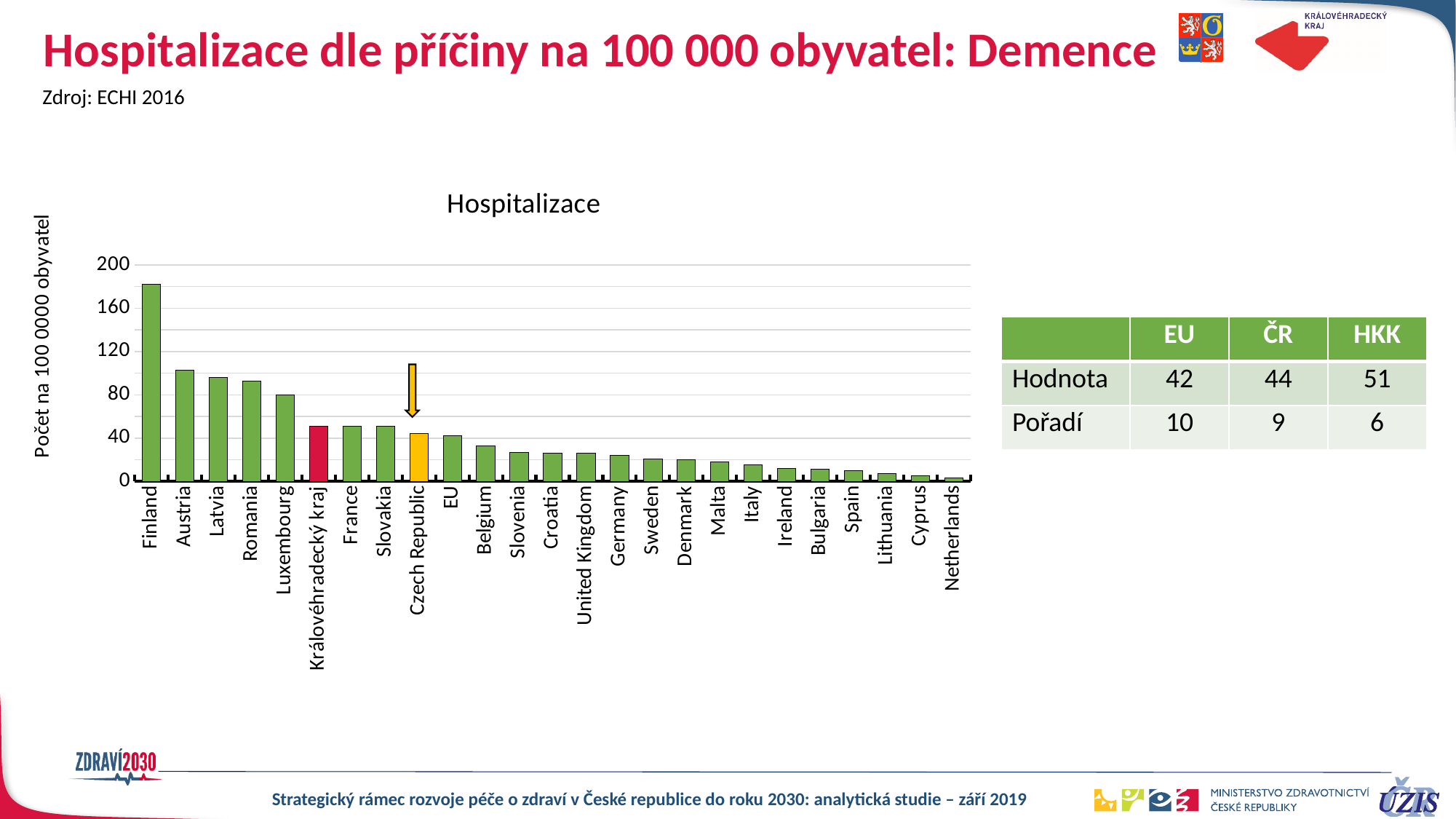
Is the value for Finland greater or less than 160? greater According to the table, what is the value (Hodnota) for HKK? 51 What type of chart is shown on the slide? bar chart How many categories (bars) are shown in the chart? 25 Which country has the lowest hospitalization rate in the chart? Netherlands Do the values rise or fall from left to right along the x axis? fall Is the value for Austria greater or less than 80? greater Which country has the highest hospitalization rate in the chart? Finland Which is larger, the value for Finland or the value for Austria? Finland What is the title of the chart? Hospitalizace According to the table, what is the difference between the value for HKK and the value for ČR? 7 Is the value for Belgium greater or less than 40? less